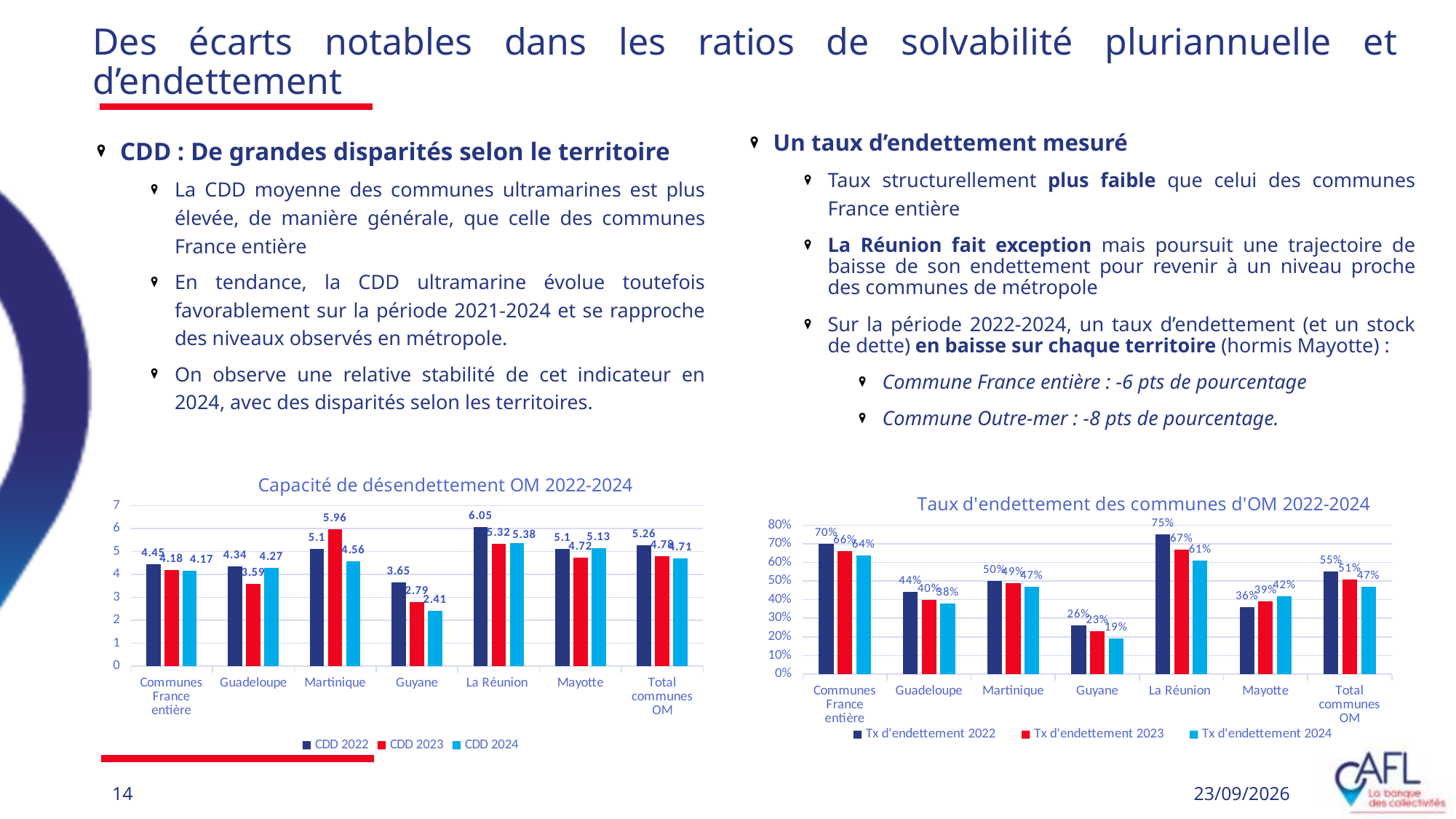
What kind of chart is the 'Taux d'endettement des communes d'OM 2022-2024' chart? bar chart In the 'Capacité de désendettement OM 2022-2024' chart, how many series does the legend list? 3 In the 'Taux d'endettement des communes d'OM 2022-2024' chart, which is larger: the Tx d'endettement 2024 value for Mayotte or for Guadeloupe? Mayotte In the 'Capacité de désendettement OM 2022-2024' chart, which territory has the lowest CDD 2024 value? Guyane In the 'Capacité de désendettement OM 2022-2024' chart, what is the difference between the CDD 2022 and CDD 2024 values for Guyane? 1.24 In the 'Taux d'endettement des communes d'OM 2022-2024' chart, which territory has the lowest Tx d'endettement 2023 value? Guyane In the 'Taux d'endettement des communes d'OM 2022-2024' chart, what is the Tx d'endettement 2024 value for Guyane? 19% In the 'Capacité de désendettement OM 2022-2024' chart, do the values for Guyane rise or fall from CDD 2022 to CDD 2024? fall In the 'Capacité de désendettement OM 2022-2024' chart, what is the CDD 2023 value for Martinique? 5.96 In the 'Taux d'endettement des communes d'OM 2022-2024' chart, what is the difference between the Tx d'endettement 2022 and Tx d'endettement 2024 values for Total communes OM? 8% In the 'Taux d'endettement des communes d'OM 2022-2024' chart, what is the Tx d'endettement 2022 value for La Réunion? 75% In the 'Capacité de désendettement OM 2022-2024' chart, which territory has the highest CDD 2022 value? La Réunion